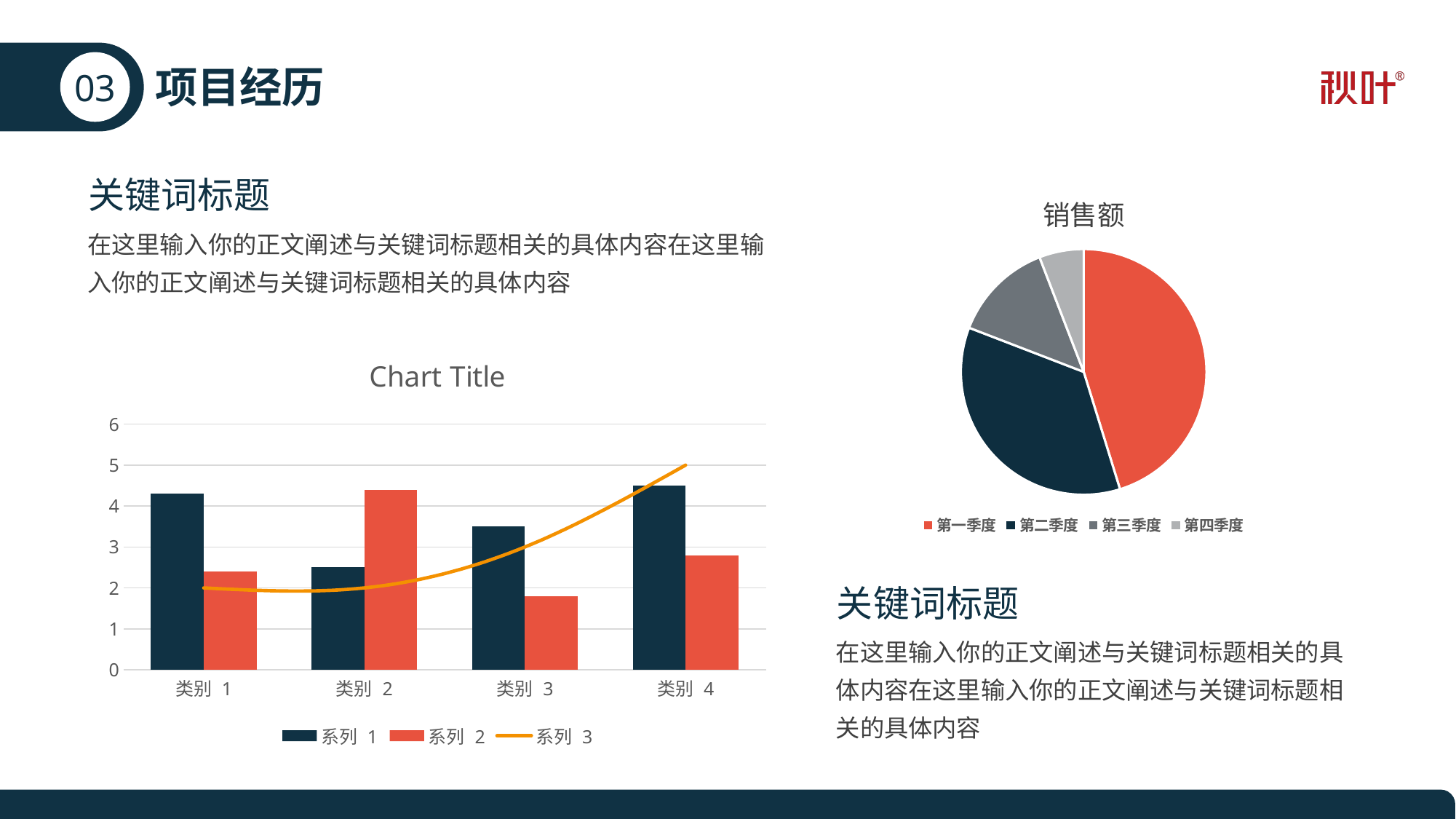
In the chart titled Chart Title, for 类别 2, which is larger: 系列 1 or 系列 2? 系列 2 In the chart titled Chart Title, is the value of 系列 2 for 类别 3 greater or less than 2? less In the chart titled 销售额, which slice is the largest? 第一季度 In the chart titled Chart Title, which category has the lowest value for 系列 1? 类别 2 How many entries does the legend of the chart titled 销售额 list? 4 In the chart titled Chart Title, which category has the highest value for 系列 2? 类别 2 In the chart titled Chart Title, which category has the lowest value for 系列 2? 类别 3 How many categories are shown on the x axis of the chart titled Chart Title? 4 How many series does the legend of the chart titled Chart Title list? 3 What kind of chart is the chart titled 销售额? pie chart In the chart titled Chart Title, is the value of 系列 1 for 类别 1 greater or less than 4? greater In the chart titled Chart Title, does the 系列 3 line rise or fall from 类别 2 to 类别 4? rise